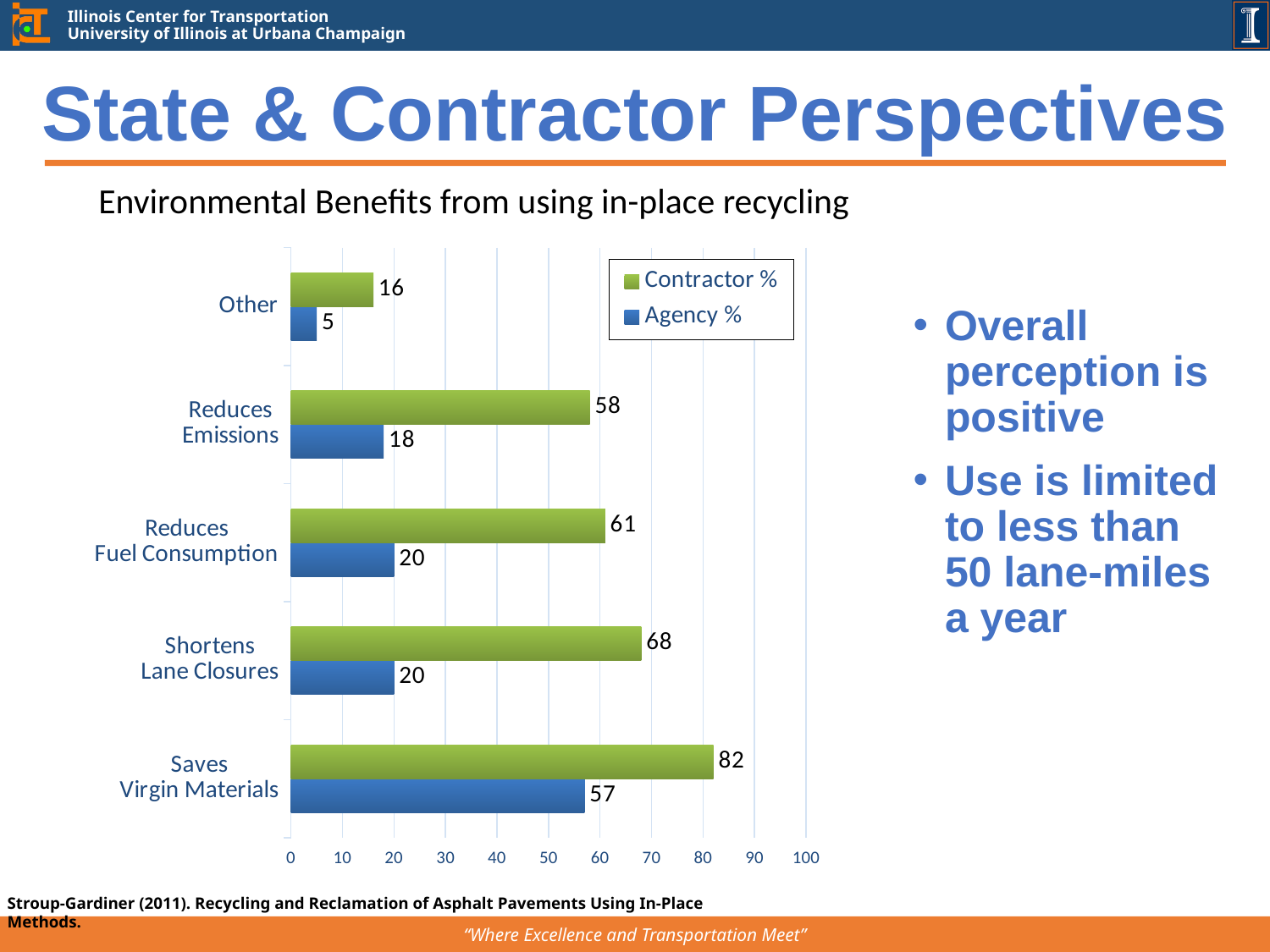
What is the Contractor % value for Saves Virgin Materials? 82 Which category has the highest Contractor % value? Saves Virgin Materials What is the Agency % value for Reduces Emissions? 18 What colour are the Agency % bars? Blue What is the Agency % value for Other? 5 What is the difference between the Contractor % and Agency % values for Shortens Lane Closures? 48 What kind of chart is shown on the slide? Bar chart What is the difference between the Contractor % values for Saves Virgin Materials and Other? 66 How many series does the legend list? 2 Which is larger for Reduces Fuel Consumption, the Contractor % or the Agency % value? Contractor % Which category has the lowest Agency % value? Other How many categories are shown on the chart? 5